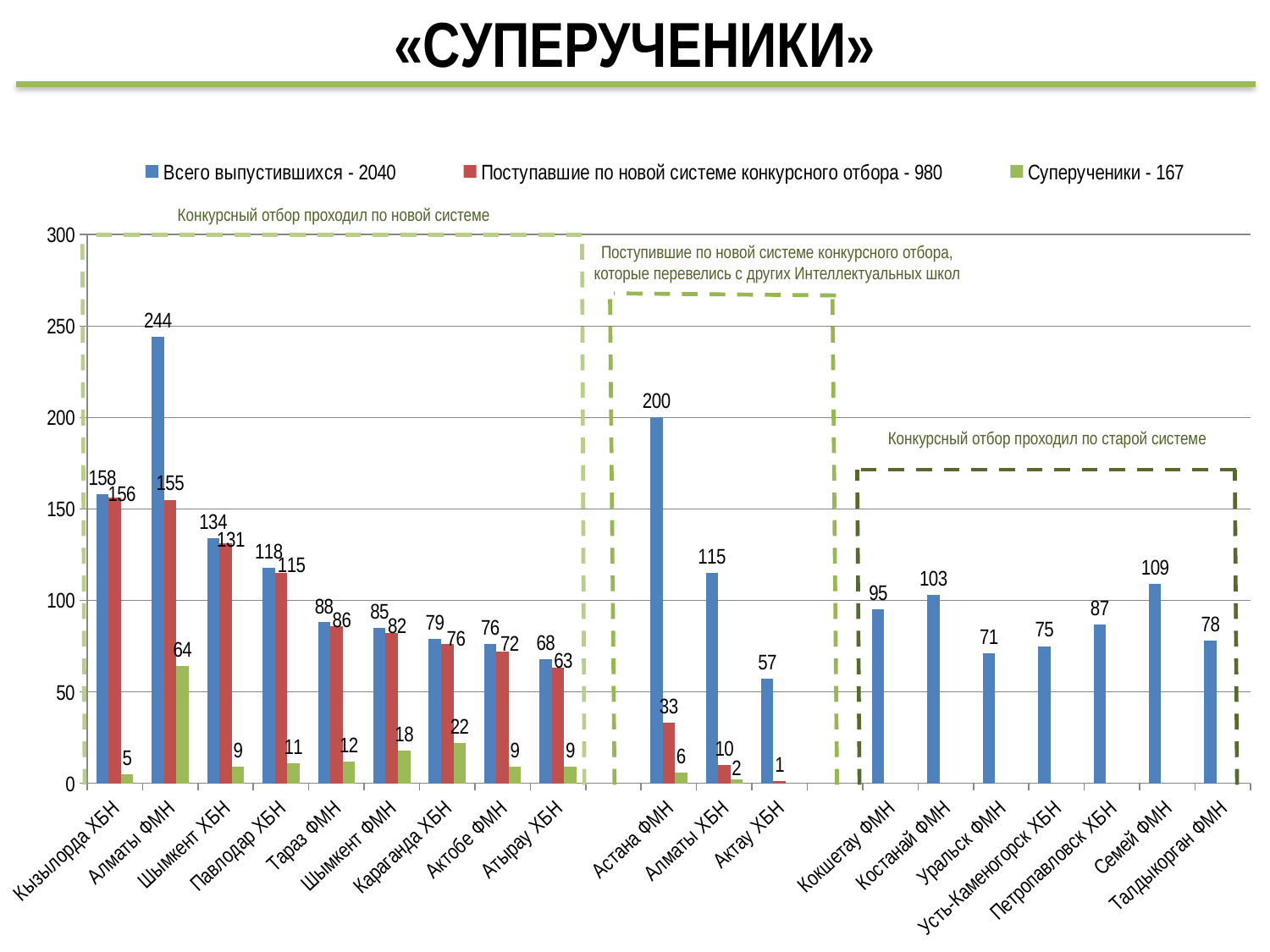
What is the value of «Суперученики» for Караганда ХБН? 22 What is the value of «Всего выпустившихся» for Алматы ФМН? 244 How many categories are shown on the x axis of the chart? 19 Which category has the highest value for «Суперученики»? Алматы ФМН Is the value of «Всего выпустившихся» for Кокшетау ФМН greater or less than 100? less What kind of chart is shown on the slide? bar chart Which category has the lowest value for «Всего выпустившихся»? Актау ХБН Which has a larger value for «Всего выпустившихся»: Семей ФМН or Костанай ФМН? Семей ФМН What is the value of «Поступавшие по новой системе конкурсного отбора» for Шымкент ХБН? 131 What is the difference between «Всего выпустившихся» and «Поступавшие по новой системе конкурсного отбора» for Астана ФМН? 167 How many series does the legend list? 3 Which category has the highest value for «Всего выпустившихся»? Алматы ФМН